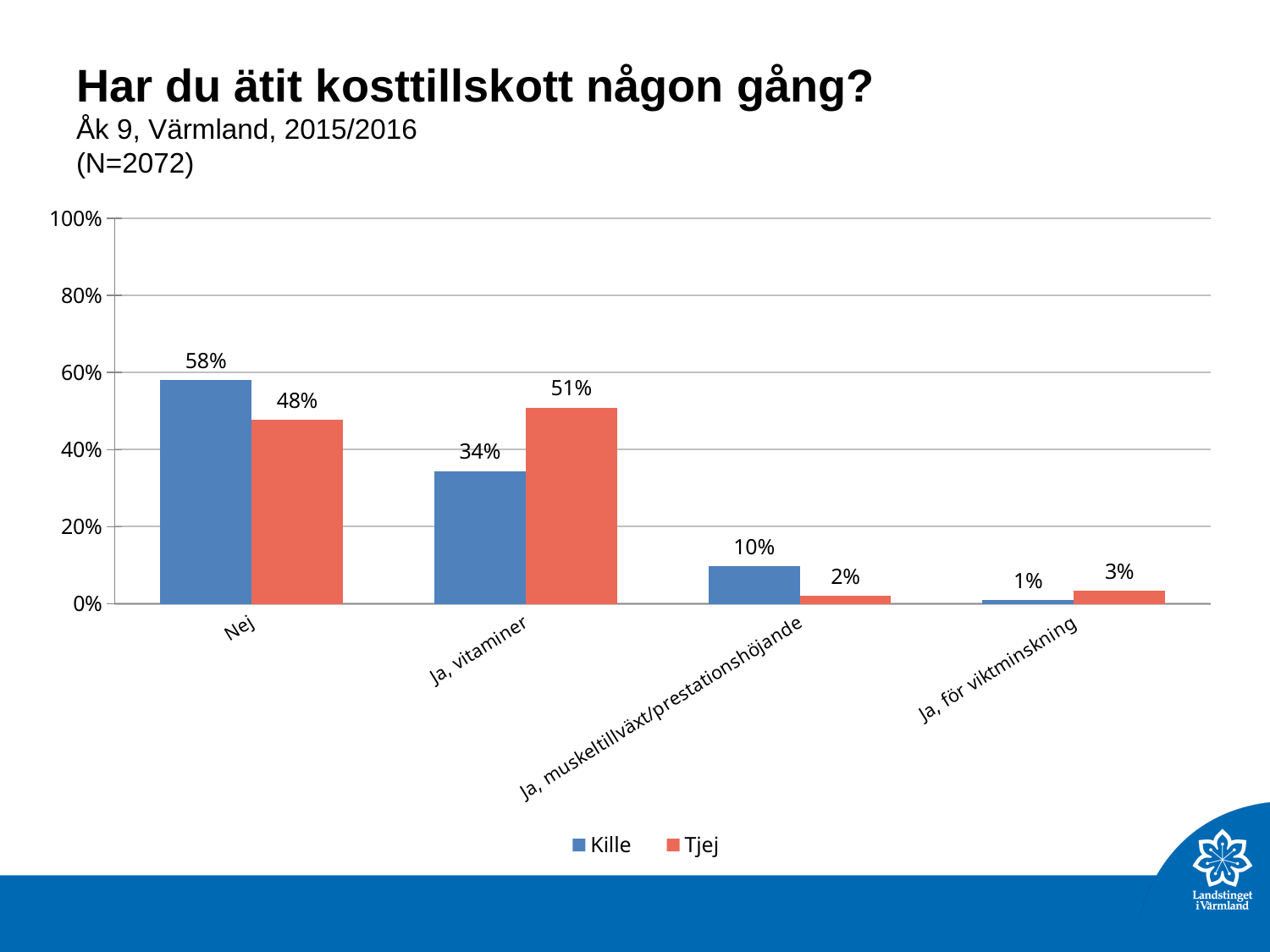
Which category has the highest value for Kille? Nej What is the difference between Kille and Tjej in the Nej category? 10% How many series does the legend list? 2 What is the value for Kille in the Nej category? 58% What colour are the Tjej bars? red Which category has the lowest value for Tjej? Ja, muskeltillväxt/prestationshöjande Is the value for Kille in the Ja, vitaminer category greater or less than 40%? less What is the value for Tjej in the Ja, för viktminskning category? 3% How many categories are shown on the x axis? 4 Which is larger in the Ja, vitaminer category, Kille or Tjej? Tjej What is the value for Tjej in the Ja, vitaminer category? 51% What kind of chart is shown on the slide? bar chart